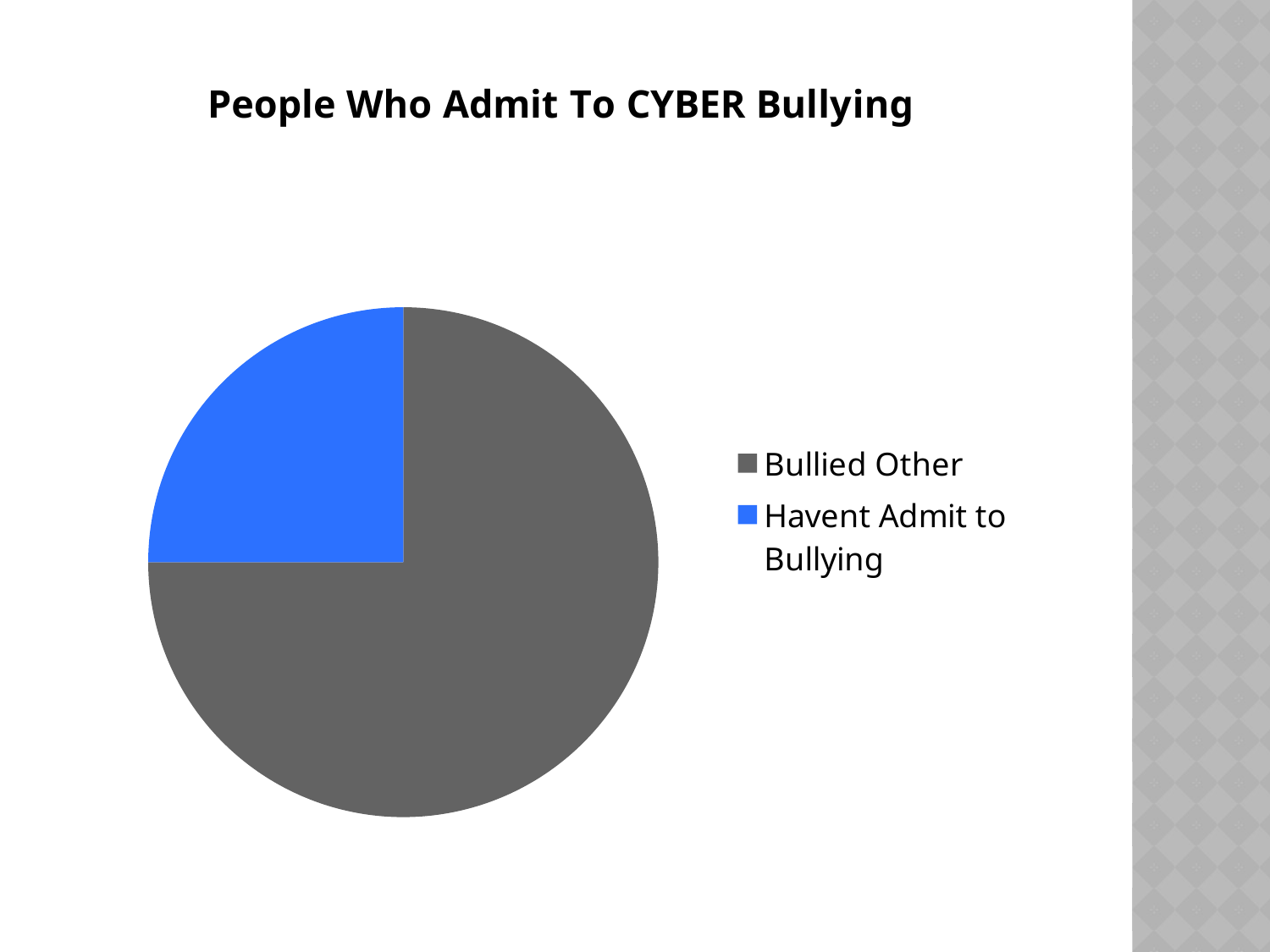
How many slices does the pie chart have? 2 What colour is the slice for Havent Admit to Bullying? blue How many entries does the legend list? 2 Which category has the smallest slice of the pie? Havent Admit to Bullying What kind of chart is shown on the slide? pie chart Which category has the largest slice of the pie? Bullied Other What is the title of the chart? People Who Admit To CYBER Bullying Which slice is larger, Bullied Other or Havent Admit to Bullying? Bullied Other